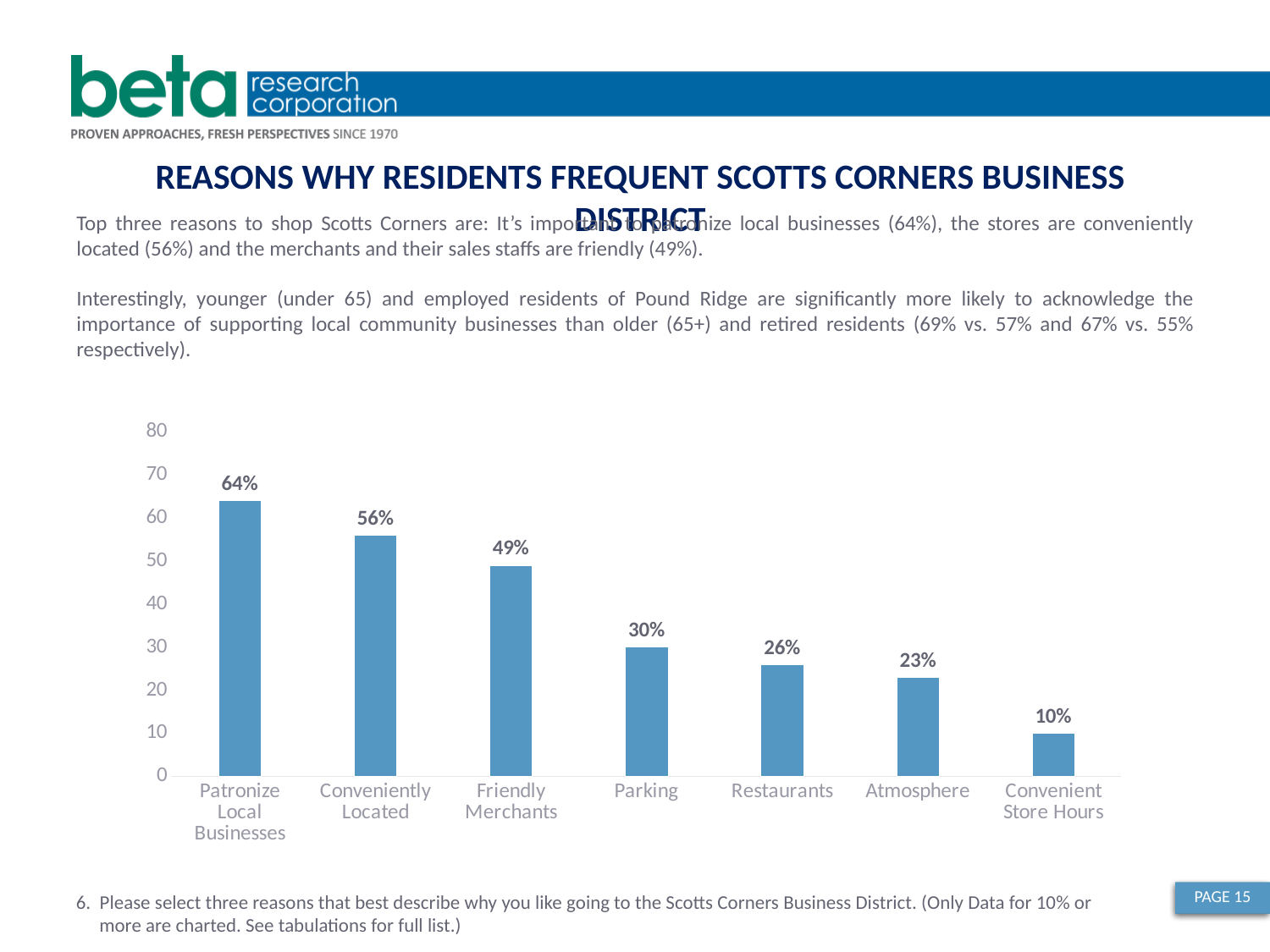
What is the difference between the values for Conveniently Located and Friendly Merchants? 7% Which is larger, the value for Parking or the value for Restaurants? Parking Which category has the highest value? Patronize Local Businesses Is the value for Friendly Merchants greater or less than 40? greater What is the value for Atmosphere? 23% What is the value for Parking? 30% Do the values rise or fall from left to right along the x axis? fall How many categories are shown in the chart? 7 Which category has the lowest value? Convenient Store Hours What is the difference between the values for Restaurants and Convenient Store Hours? 16% What is the value for Patronize Local Businesses? 64% What kind of chart is shown on the slide? bar chart